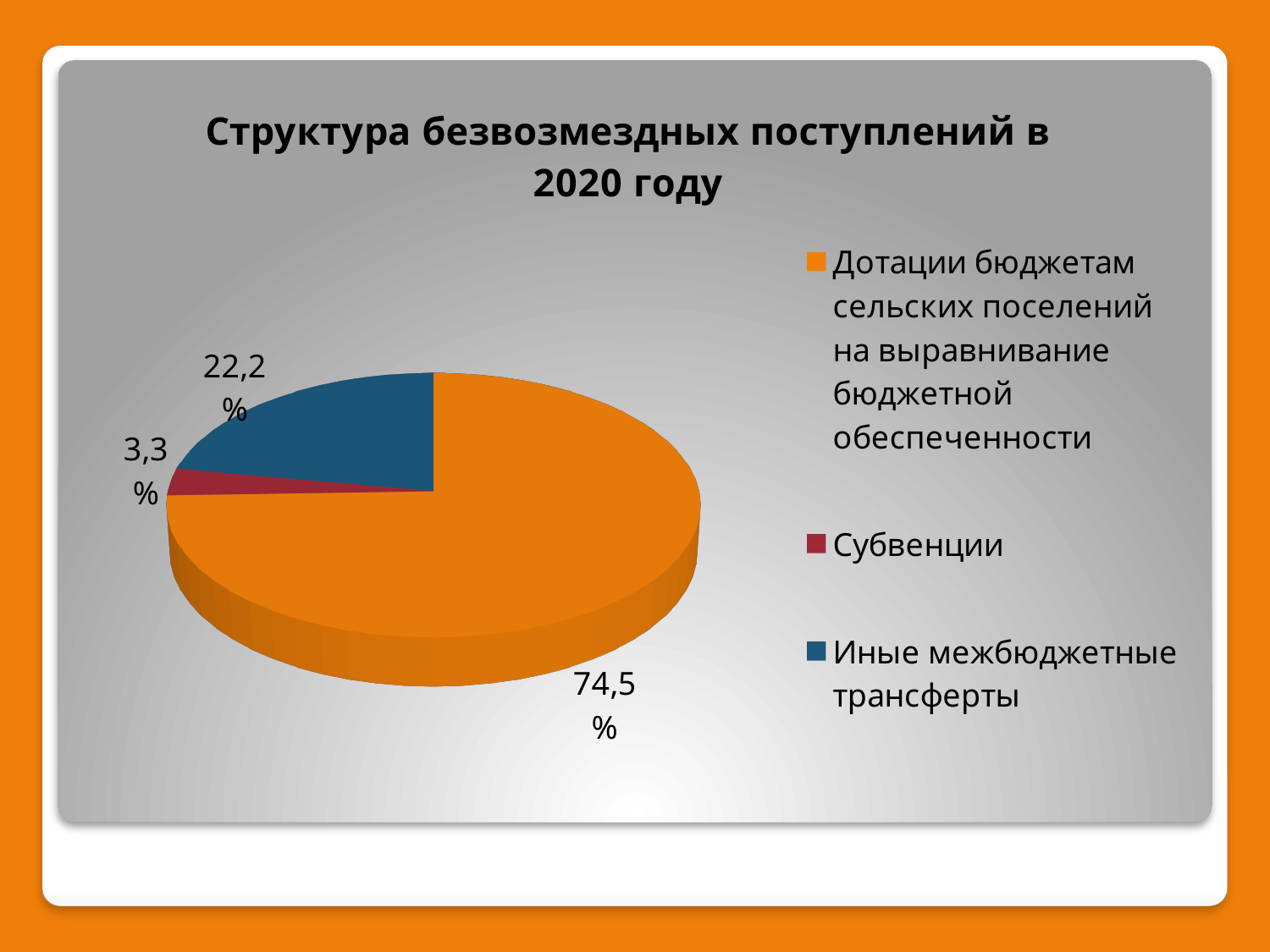
Which is larger: the slice for 'Иные межбюджетные трансферты' or the slice for 'Субвенции'? Иные межбюджетные трансферты What is the difference in percentage points between 'Иные межбюджетные трансферты' and 'Субвенции'? 18,9 What colour is the slice for 'Субвенции'? Red Which category has the largest slice of the pie? Дотации бюджетам сельских поселений на выравнивание бюджетной обеспеченности What kind of chart is shown on the slide? Pie chart What share of the pie does 'Дотации бюджетам сельских поселений на выравнивание бюджетной обеспеченности' represent? 74,5% How many entries does the legend list? 3 Which category has the smallest slice of the pie? Субвенции What is the title of the chart? Структура безвозмездных поступлений в 2020 году How many slices does the pie chart have? 3 What share of the pie does 'Иные межбюджетные трансферты' represent? 22,2% What share of the pie does 'Субвенции' represent? 3,3%